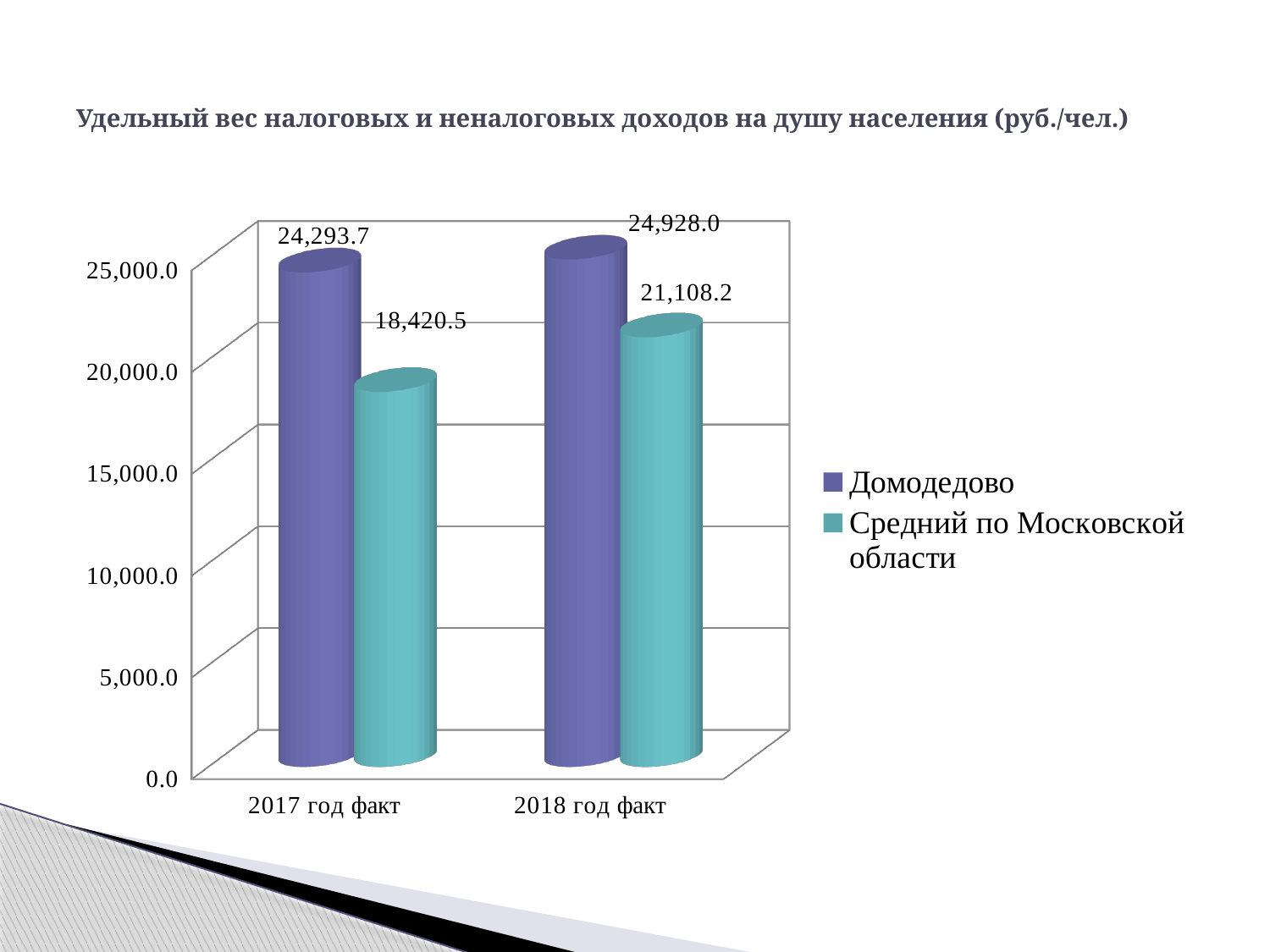
What is the value for Домодедово in 2017 год факт? 24,293.7 What is the difference between Домодедово and Средний по Московской области in 2017 год факт? 5,873.2 How many series does the legend list? 2 Which series has the highest value in 2018 год факт? Домодедово Which bar has the lowest value on the chart? Средний по Московской области, 2017 год факт By how much did the value for Средний по Московской области increase from 2017 год факт to 2018 год факт? 2,687.7 How many categories are shown on the x axis? 2 Which is larger: Домодедово in 2017 год факт or Средний по Московской области in 2018 год факт? Домодедово in 2017 год факт What kind of chart is shown on the slide? Bar chart What is the value for Средний по Московской области in 2017 год факт? 18,420.5 What is the value for Домодедово in 2018 год факт? 24,928.0 What is the value for Средний по Московской области in 2018 год факт? 21,108.2